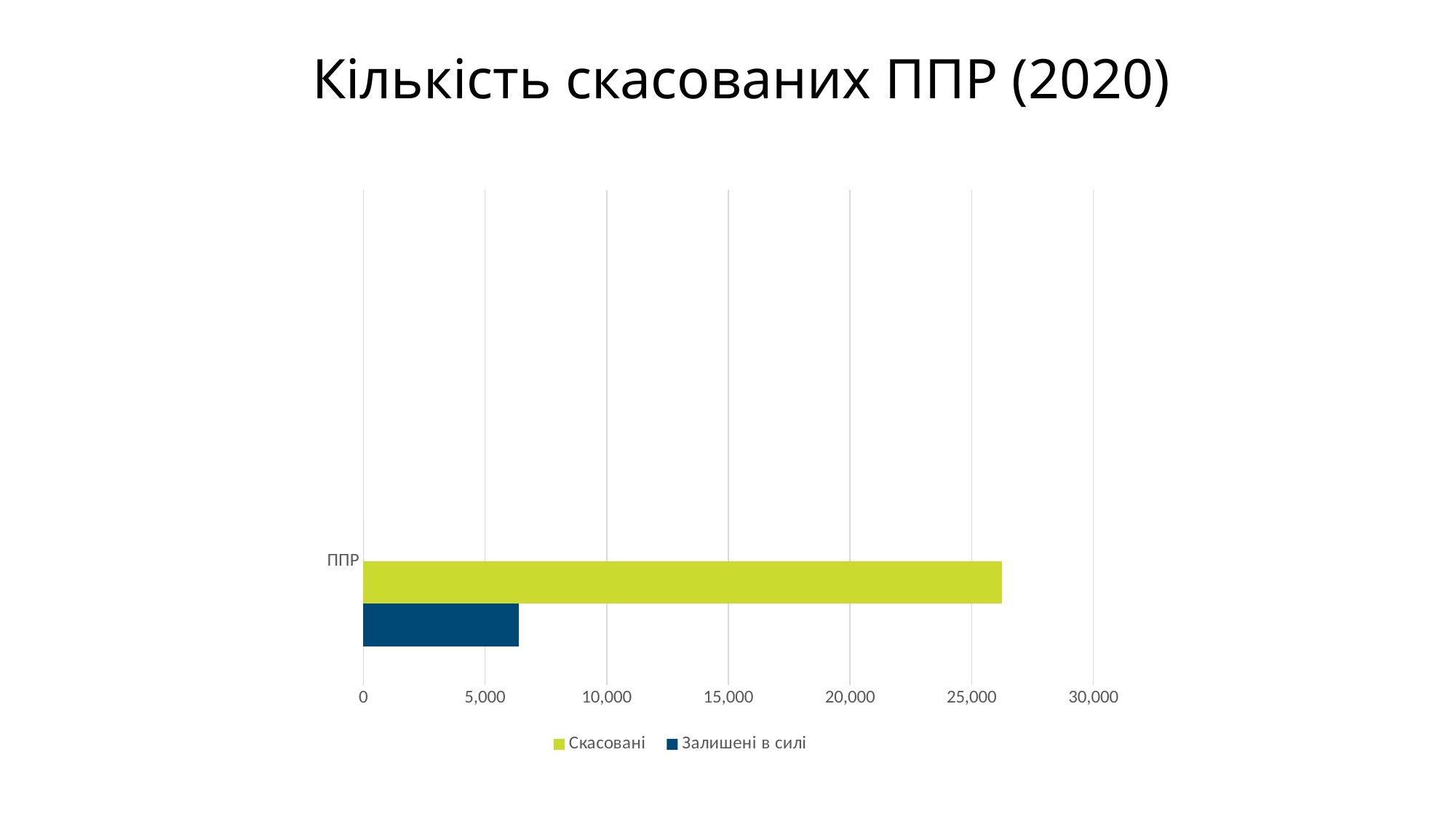
How many series does the legend list? 2 What colour is the bar for the Скасовані series? green What is the title of the chart? Кількість скасованих ППР (2020) Is the value for Скасовані greater or less than 25,000? greater Is the value for Залишені в силі greater or less than 5,000? greater How many categories are plotted on the vertical axis? 1 Is the value for Скасовані greater or less than 30,000? less Which series has the larger value for ППР, Скасовані or Залишені в силі? Скасовані What kind of chart is shown on the slide? bar chart Which series has the smallest value? Залишені в силі What is the highest value shown on the horizontal axis? 30,000